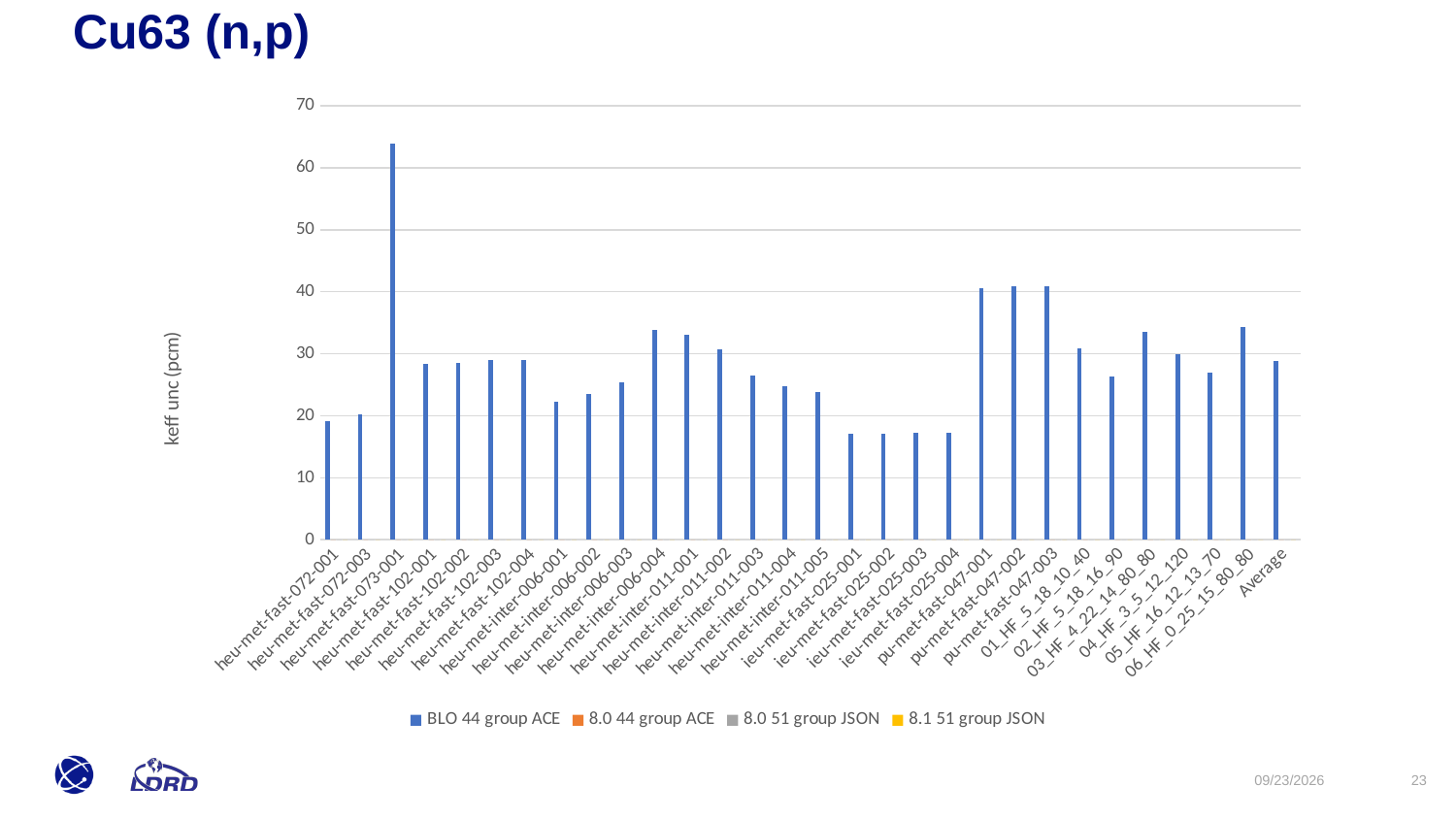
What is the title of the slide containing the chart? Cu63 (n,p) Which category has the highest keff unc (pcm) value? heu-met-fast-073-001 Is the value for ieu-met-fast-025-001 greater or less than 20? less Which is larger, the value for heu-met-inter-006-004 or the value for ieu-met-fast-025-002? heu-met-inter-006-004 What kind of chart is shown on the slide? bar chart What is the label of the y axis? keff unc (pcm) Which is larger, the value for heu-met-fast-073-001 or the value for pu-met-fast-047-001? heu-met-fast-073-001 How many categories are shown on the x axis? 30 Is the value for heu-met-inter-006-004 greater or less than 30? greater Is the value for pu-met-fast-047-001 greater or less than 30? greater How many series does the legend list? 4